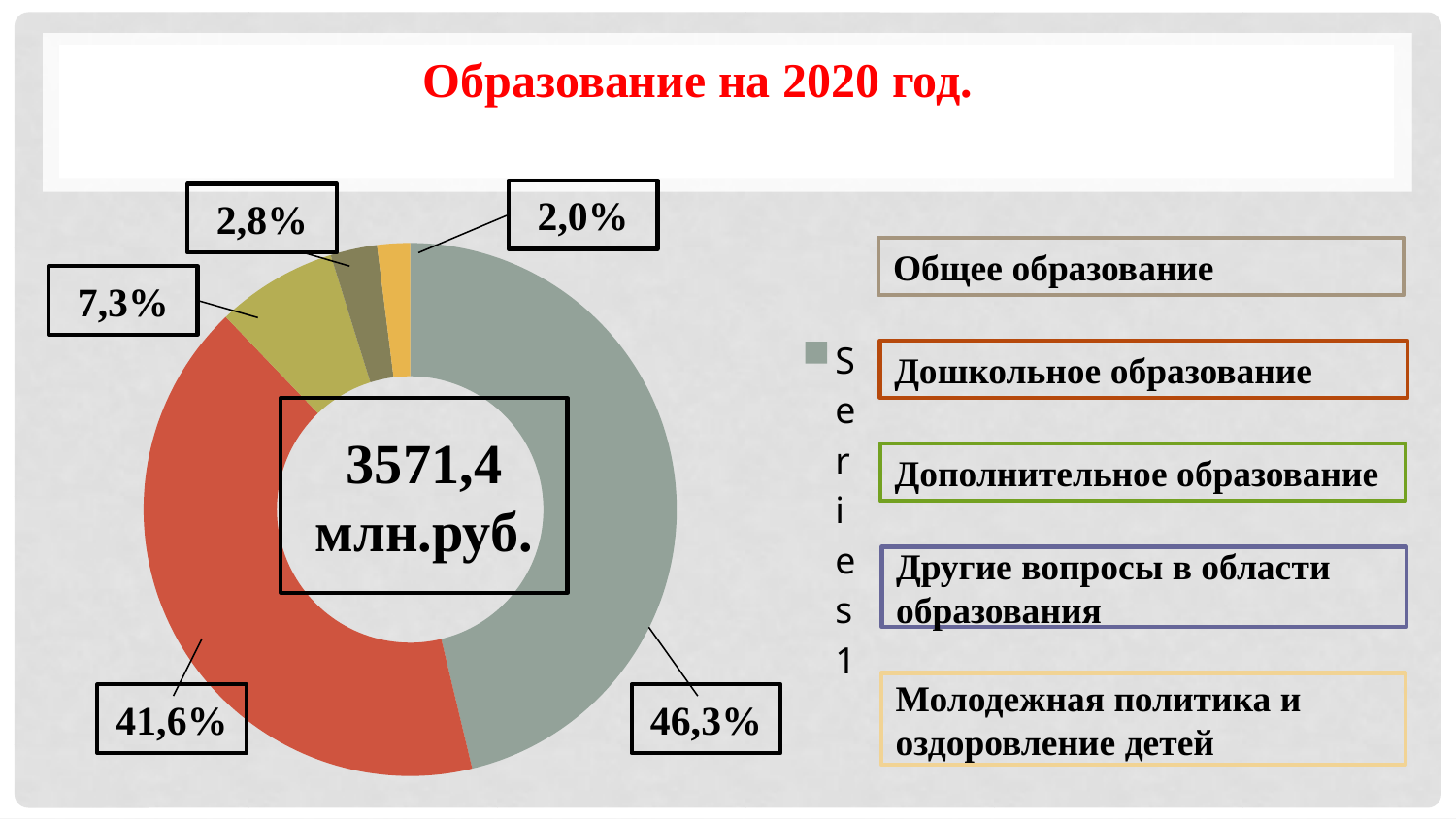
What share does the grey-green slice (Общее образование) represent? 46,3% What series name does the chart legend show? Series1 What total amount is shown in the centre of the doughnut chart? 3571,4 млн.руб. What is the difference between the largest slice (46,3%) and the second largest slice (41,6%)? 4,7% Which is larger: the slice labelled 7,3% or the slice labelled 2,8%? 7,3% What share does the red slice (Дошкольное образование) represent? 41,6% What is the title of the chart on the slide? Образование на 2020 год. What share does the yellow slice (Молодежная политика и оздоровление детей) represent? 2,0% What kind of chart is shown on the slide? Doughnut (pie) chart How many slices does the doughnut chart have? 5 What is the largest share shown on the doughnut chart? 46,3% What is the smallest share shown on the doughnut chart? 2,0%